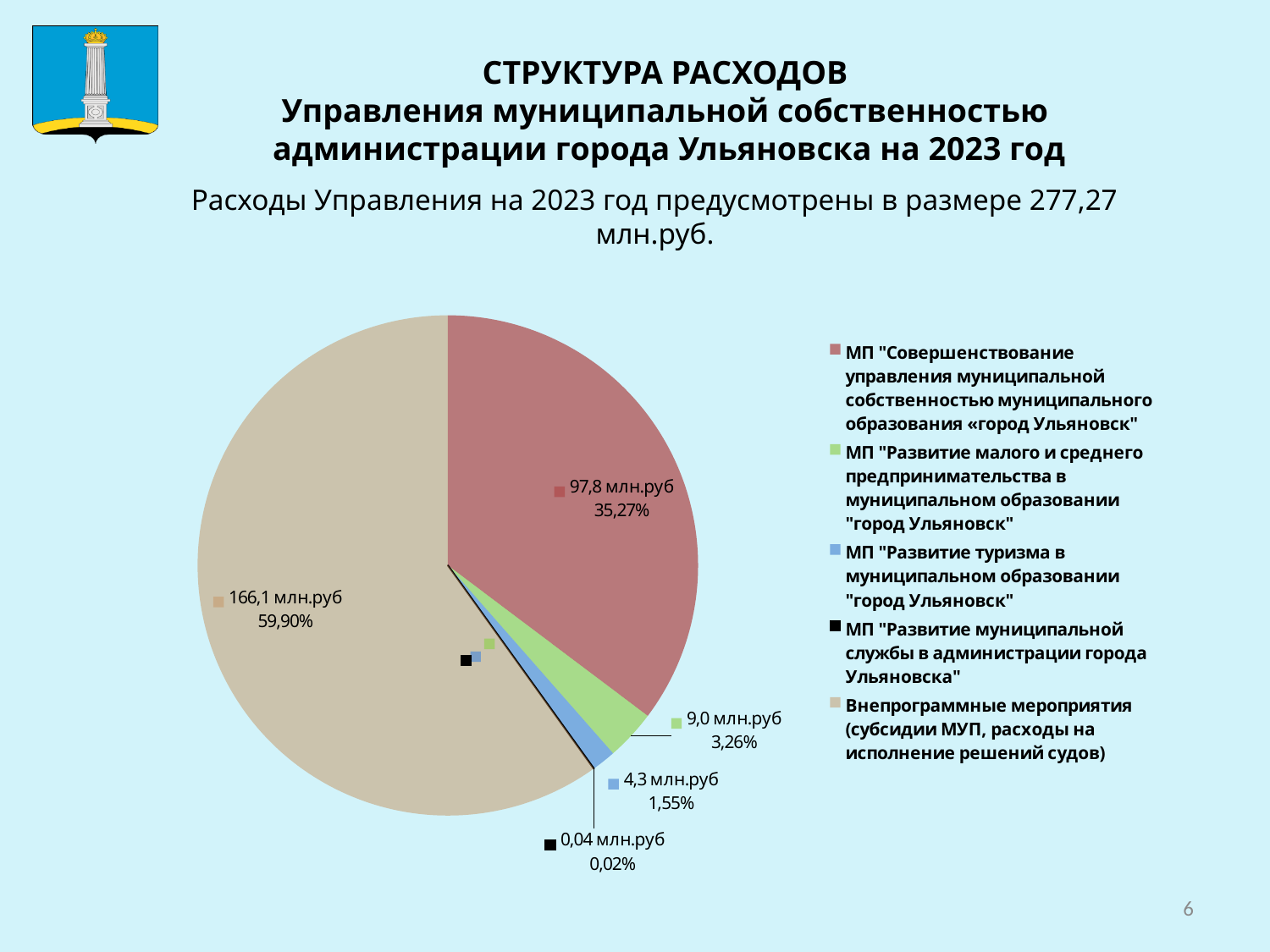
What percentage share is shown for МП "Развитие туризма в муниципальном образовании "город Ульяновск""? 1,55% What is the value in млн.руб for МП "Развитие малого и среднего предпринимательства в муниципальном образовании "город Ульяновск""? 9,0 млн.руб How many slices does the pie chart have? 5 Which category has the largest slice of the pie? Внепрограммные мероприятия (субсидии МУП, расходы на исполнение решений судов) What type of chart is shown on the slide? pie chart Which category has the smallest slice of the pie? МП "Развитие муниципальной службы в администрации города Ульяновска" What is the value in млн.руб for МП "Развитие муниципальной службы в администрации города Ульяновска"? 0,04 млн.руб Which is larger: the slice for МП "Развитие малого и среднего предпринимательства..." or the slice for МП "Развитие туризма..."? МП "Развитие малого и среднего предпринимательства в муниципальном образовании "город Ульяновск"" What is the value in млн.руб for "Внепрограммные мероприятия"? 166,1 млн.руб What share of the pie does МП "Совершенствование управления муниципальной собственностью муниципального образования «город Ульяновск»" represent? 35,27% What is the difference in млн.руб between "Внепрограммные мероприятия" and МП "Совершенствование управления муниципальной собственностью..."? 68,3 млн.руб How many entries does the legend list? 5